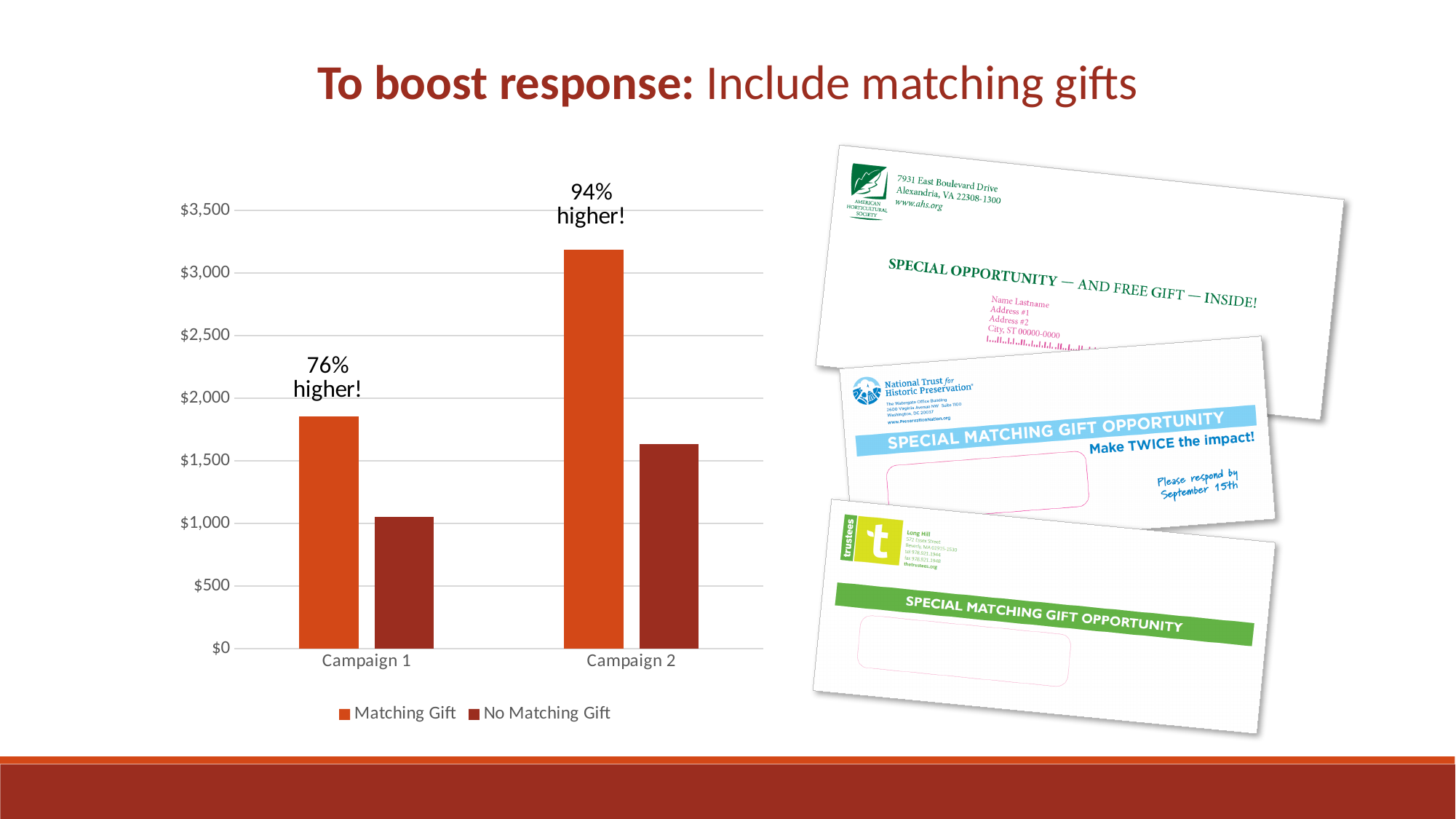
Is the No Matching Gift value for Campaign 1 greater or less than $1,500? less Is the Matching Gift value for Campaign 2 greater or less than $3,000? greater How many campaigns are shown on the x axis of the chart? 2 How many series does the chart legend list? 2 Which series has the higher value for Campaign 1, Matching Gift or No Matching Gift? Matching Gift According to the annotation on the chart, by what percentage is the Matching Gift result higher for Campaign 2? 94% higher! Which series has the higher value for Campaign 2, Matching Gift or No Matching Gift? Matching Gift Is the No Matching Gift value for Campaign 2 greater or less than $2,000? less What kind of chart is shown on the slide? bar chart Which campaign has the higher Matching Gift value? Campaign 2 Which campaign has the lower No Matching Gift value? Campaign 1 According to the annotation on the chart, by what percentage is the Matching Gift result higher for Campaign 1? 76% higher!